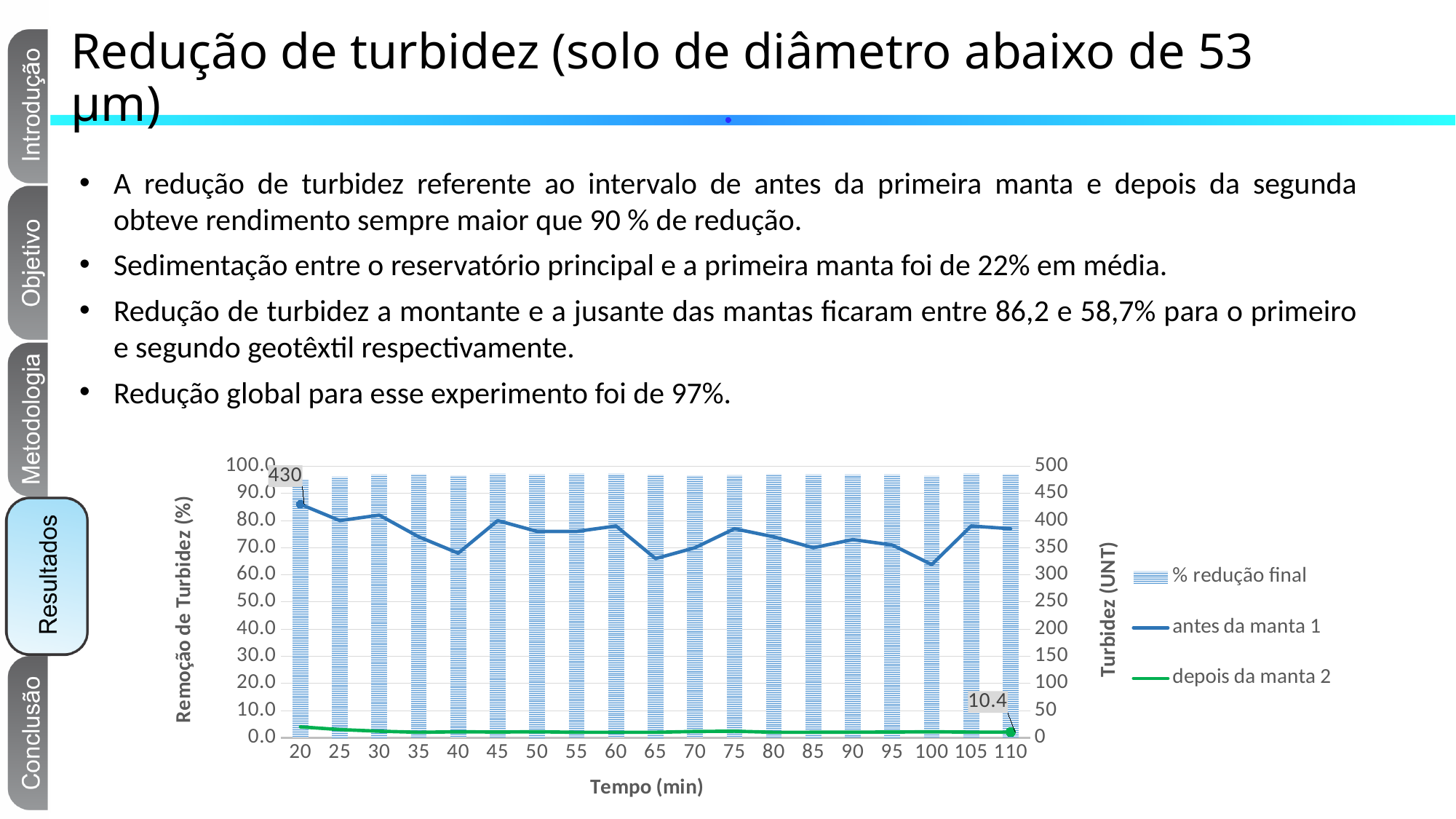
What is the title of the left vertical axis? Remoção de Turbidez (%) Is the value of 'antes da manta 1' at 100 min greater or less than 400? less At which time does 'antes da manta 1' reach its highest value? 20 min What is the value of 'antes da manta 1' at 20 min? 430 Is the '% redução final' bar at 50 min greater or less than 90? greater How many series does the legend list? 3 At 110 min, which series has the larger value: 'antes da manta 1' or 'depois da manta 2'? antes da manta 1 What is the title of the x axis? Tempo (min) How many time points are shown on the x axis? 19 What is the value of 'depois da manta 2' at 110 min? 10.4 What kind of chart is shown on the slide? Combined bar and line chart Which is larger for 'antes da manta 1': the value at 20 min or at 100 min? 20 min